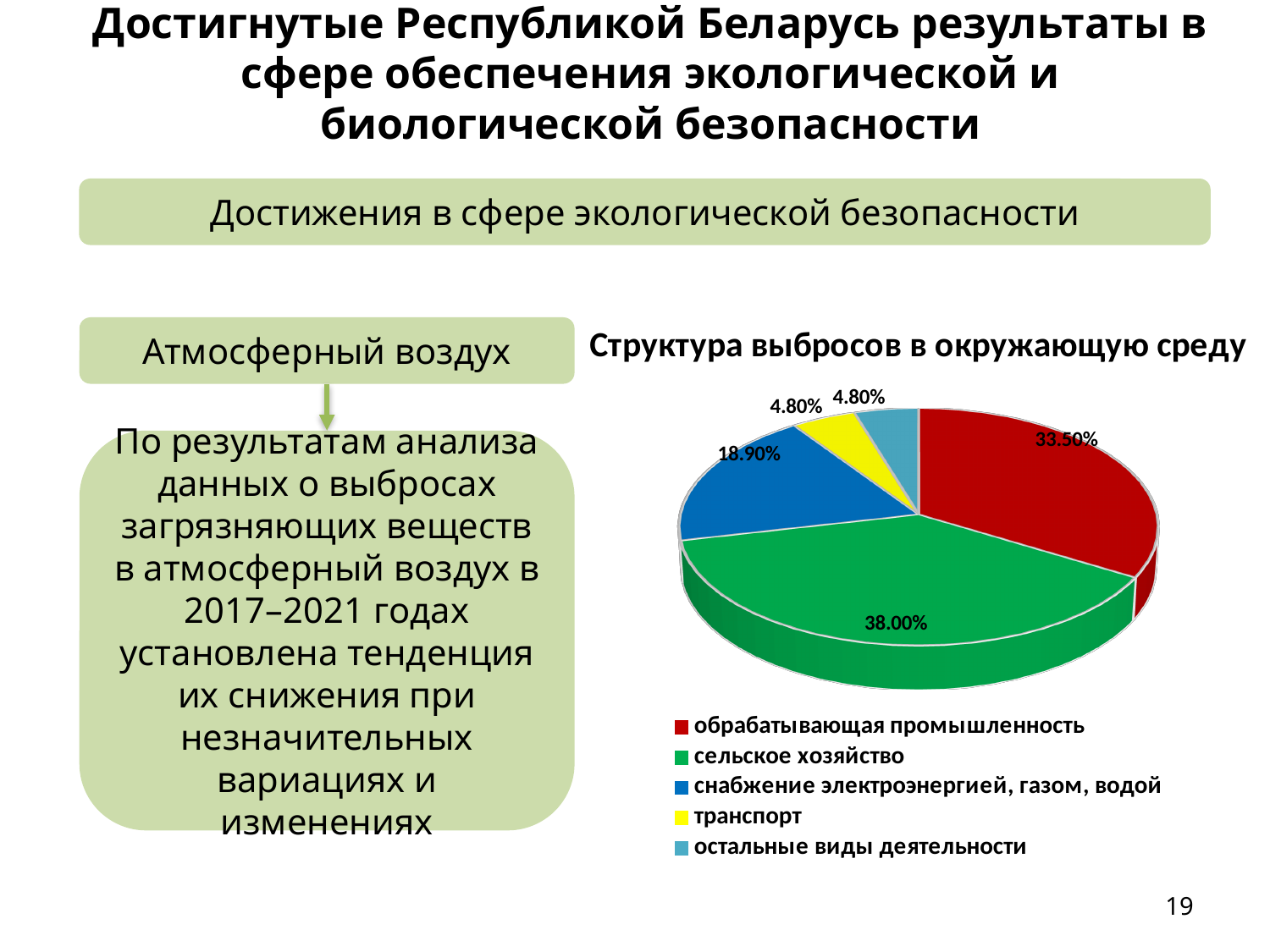
Which category has the largest share of the pie? сельское хозяйство Which colour represents остальные виды деятельности in the pie chart? Light blue What is the value shown for снабжение электроэнергией, газом, водой? 18.90% Which is larger: the share of обрабатывающая промышленность or the share of снабжение электроэнергией, газом, водой? обрабатывающая промышленность What is the value shown for обрабатывающая промышленность? 33.50% What is the value shown for транспорт? 4.80% What share of the pie does сельское хозяйство account for? 38.00% What type of chart is shown on the slide? Pie chart How many slices does the pie chart have? 5 How many entries does the chart legend list? 5 What is the title of the chart on the slide? Структура выбросов в окружающую среду What is the difference between the shares of сельское хозяйство and обрабатывающая промышленность? 4.50%